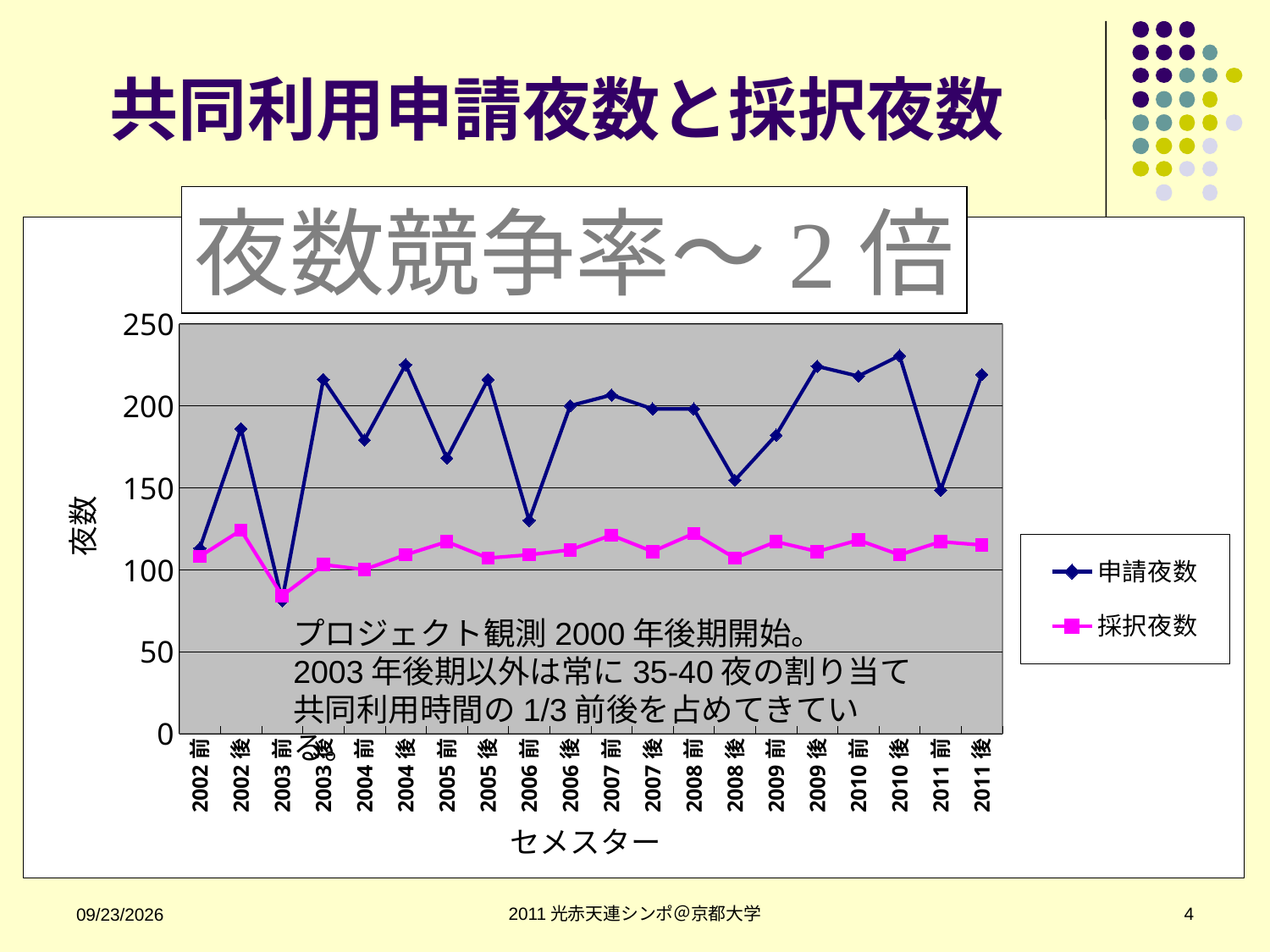
What are the two series named in the legend? 申請夜数 and 採択夜数 How many semesters are plotted along the x axis? 20 Is the value of 申請夜数 for 2003前 greater or less than 100? less In which semester is 申請夜数 at its lowest? 2003前 Is the value of 申請夜数 for 2010後 greater or less than 200? greater What kind of chart is shown on the slide? line chart How many series does the chart legend list? 2 Which is larger for 2005後, 申請夜数 or 採択夜数? 申請夜数 Is the value of 採択夜数 for 2002後 greater or less than 100? greater What is the label of the y axis? 夜数 In which semester is 採択夜数 at its lowest? 2003前